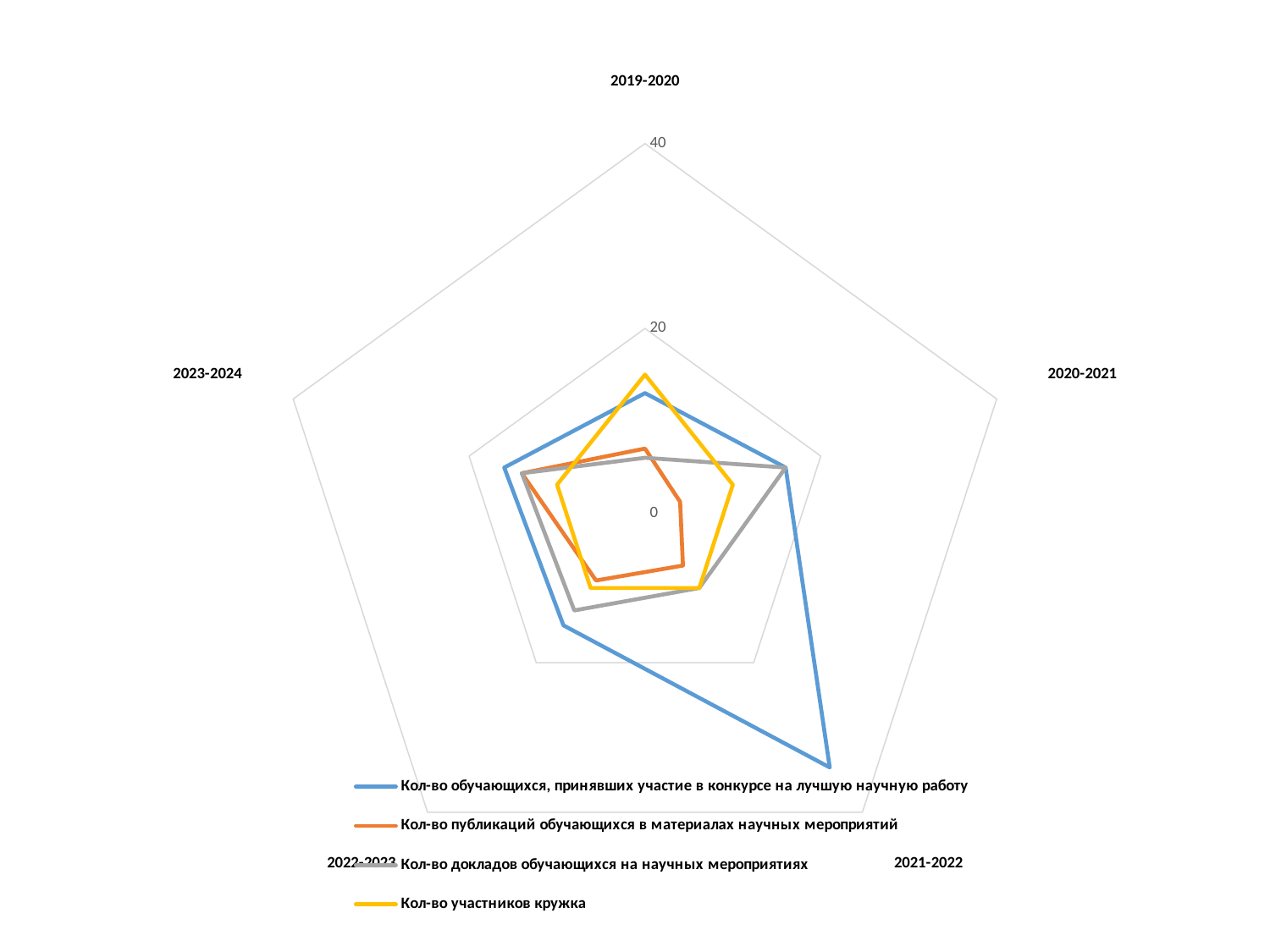
What is the highest tick value shown on the radar chart's axis? 40 Is the value for 2020-2021 in the series "Кол-во публикаций обучающихся в материалах научных мероприятий" greater or less than 20? less Is the value for 2021-2022 in the series "Кол-во обучающихся, принявших участие в конкурсе на лучшую научную работу" greater or less than 20? greater What kind of chart is shown on the slide? Radar chart For 2021-2022, which series has the larger value: "Кол-во обучающихся, принявших участие в конкурсе на лучшую научную работу" or "Кол-во публикаций обучающихся в материалах научных мероприятий"? Кол-во обучающихся, принявших участие в конкурсе на лучшую научную работу How many academic-year categories does the radar chart have? 5 How many series does the legend list? 4 For 2019-2020, which series has the larger value: "Кол-во участников кружка" or "Кол-во докладов обучающихся на научных мероприятиях"? Кол-во участников кружка What colour is the line for the series "Кол-во участников кружка"? Yellow In which academic year does the series "Кол-во публикаций обучающихся в материалах научных мероприятий" have its lowest value? 2020-2021 In which academic year does the series "Кол-во обучающихся, принявших участие в конкурсе на лучшую научную работу" reach its highest value? 2021-2022 Is the value for 2019-2020 in the series "Кол-во участников кружка" greater or less than 20? less